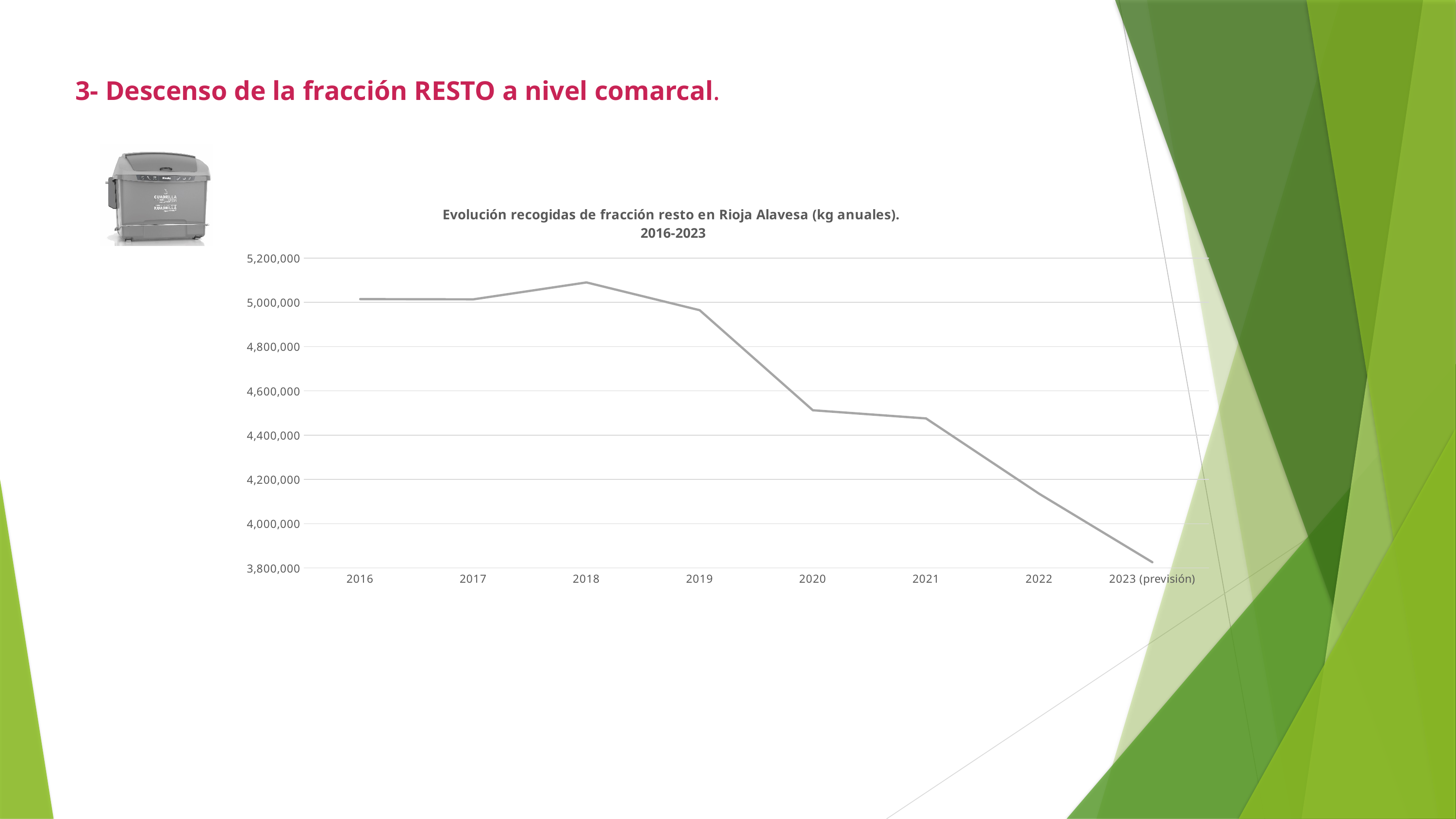
Is the value for 2022 greater or less than 4,000,000? greater How many years (data points) are plotted on the x axis? 8 What kind of chart is shown on the slide? line chart What is the title of the chart? Evolución recogidas de fracción resto en Rioja Alavesa (kg anuales). 2016-2023 Is the value for 2019 greater or less than 5,000,000? less Is the value for 2020 greater or less than 4,600,000? less Do the values generally rise or fall from 2018 to 2023 (previsión)? fall Which year has the lowest value on the chart? 2023 (previsión) Which year has the highest value on the chart? 2018 Which is larger, the value for 2019 or the value for 2020? 2019